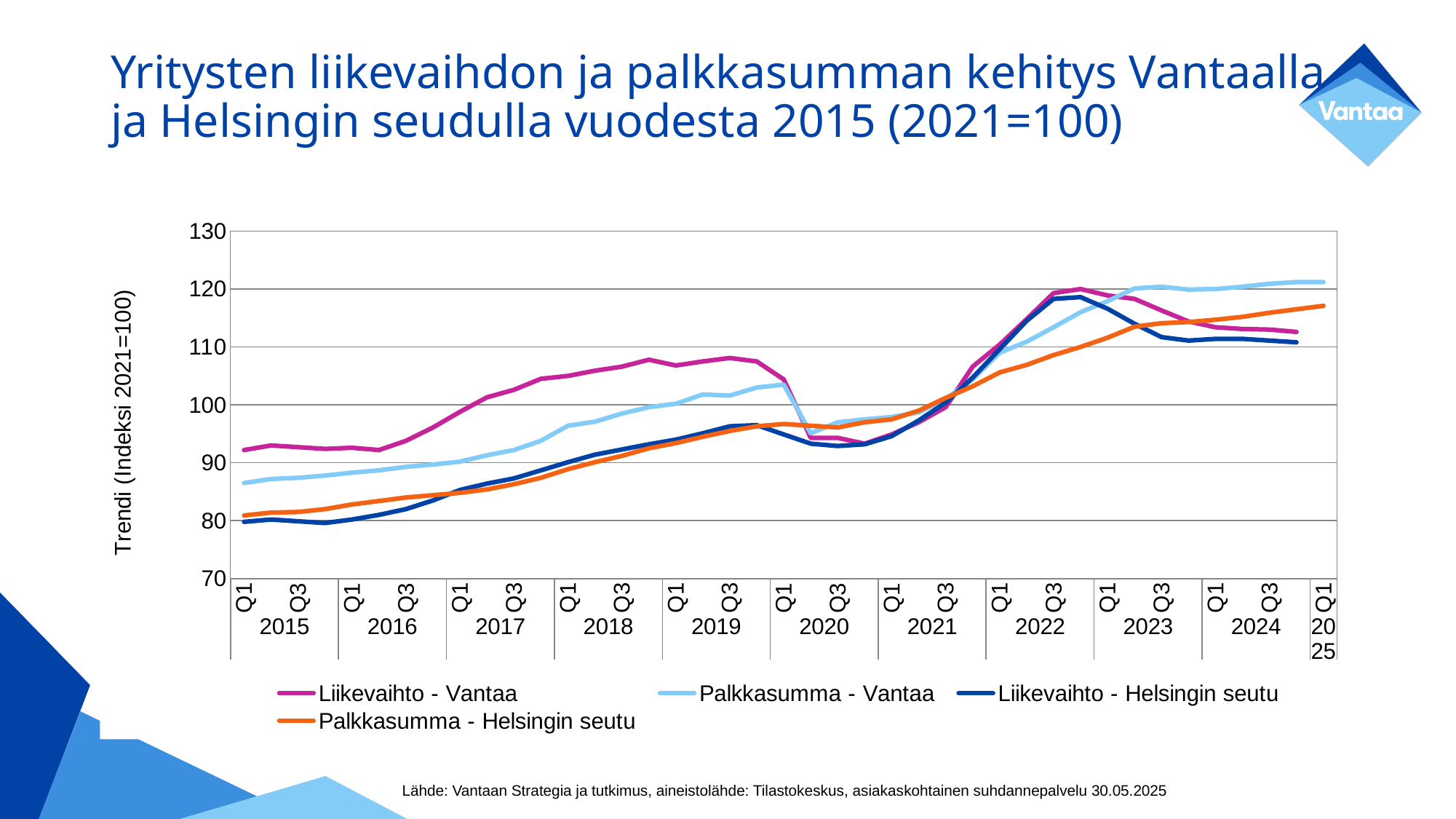
Is the value for Palkkasumma - Vantaa at Q1 2015 greater or less than 90? less Is the value for Liikevaihto - Vantaa at Q1 2015 greater or less than 90? greater Which series has the highest value at Q1 2025? Palkkasumma - Vantaa Is the value for Palkkasumma - Helsingin seutu at Q1 2025 greater or less than 120? less What is the label of the vertical axis? Trendi (Indeksi 2021=100) At Q1 2015, which is larger: Liikevaihto - Vantaa or Palkkasumma - Vantaa? Liikevaihto - Vantaa What kind of chart is shown on the slide? line chart Which year labels appear on the horizontal axis, from first to last? 2015 to 2025 How many series does the legend list? 4